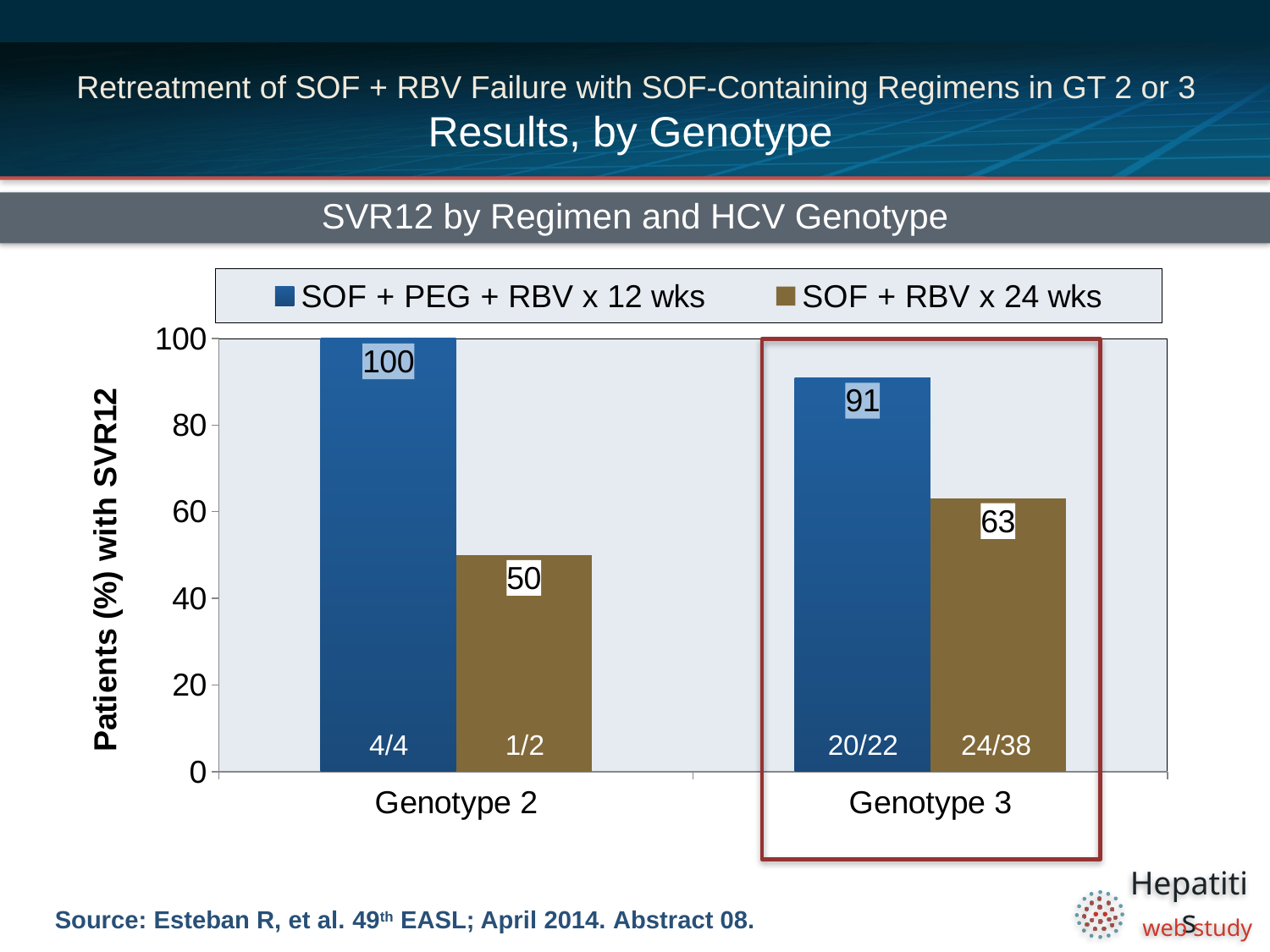
Which regimen has the larger SVR12 value in Genotype 2? SOF + PEG + RBV x 12 wks What is the difference between the SOF + PEG + RBV x 12 wks and SOF + RBV x 24 wks values in Genotype 3? 28 What is the SVR12 value for SOF + PEG + RBV x 12 wks in Genotype 2? 100 Which bar has the highest SVR12 value? SOF + PEG + RBV x 12 wks, Genotype 2 What is the SVR12 value for SOF + PEG + RBV x 12 wks in Genotype 3? 91 What is the SVR12 value for SOF + RBV x 24 wks in Genotype 3? 63 What is the SVR12 value for SOF + RBV x 24 wks in Genotype 2? 50 What is the patient fraction shown at the base of the SOF + RBV x 24 wks bar in Genotype 3? 24/38 How many genotype categories are shown on the x axis? 2 Which bar has the lowest SVR12 value? SOF + RBV x 24 wks, Genotype 2 How many series does the legend list? 2 What kind of chart is shown? Bar chart